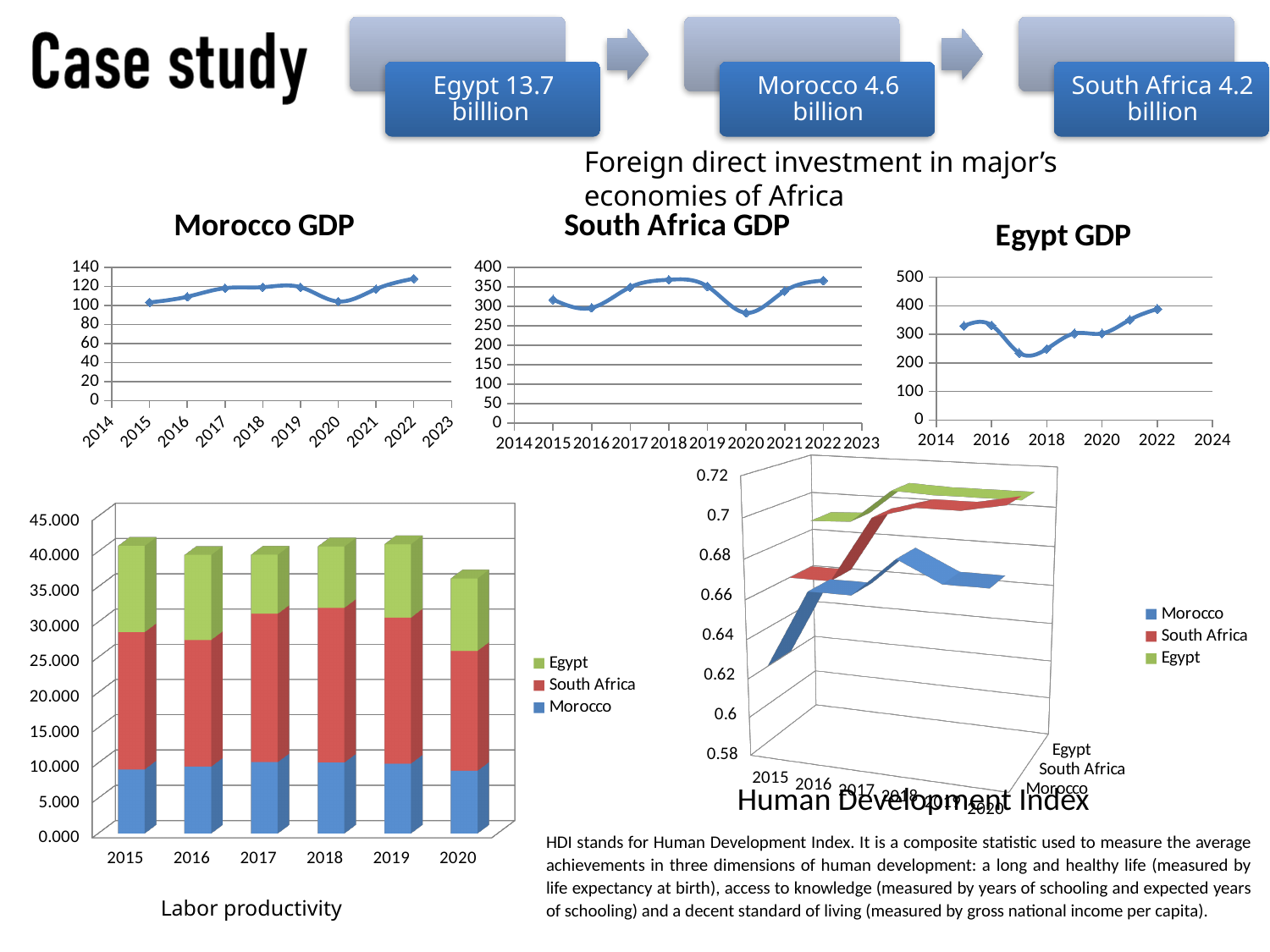
What kind of chart is the Labor productivity chart? stacked bar chart How many years are shown on the x axis of the Human Development Index chart? 6 In the Morocco GDP chart, which year has the highest value? 2022 In the Egypt GDP chart, which year has the highest value? 2022 What kind of chart is the Morocco GDP chart? line chart In the Morocco GDP chart, is the value for 2020 greater or less than 120? less In the Egypt GDP chart, is the value for 2017 greater or less than 300? less In the South Africa GDP chart, is the value for 2020 greater or less than 300? less In the Egypt GDP chart, which year has the lowest value? 2017 In the Labor productivity chart, which year has the lowest total bar? 2020 How many series does the legend of the Labor productivity chart list? 3 In the South Africa GDP chart, which year has the lowest value? 2020